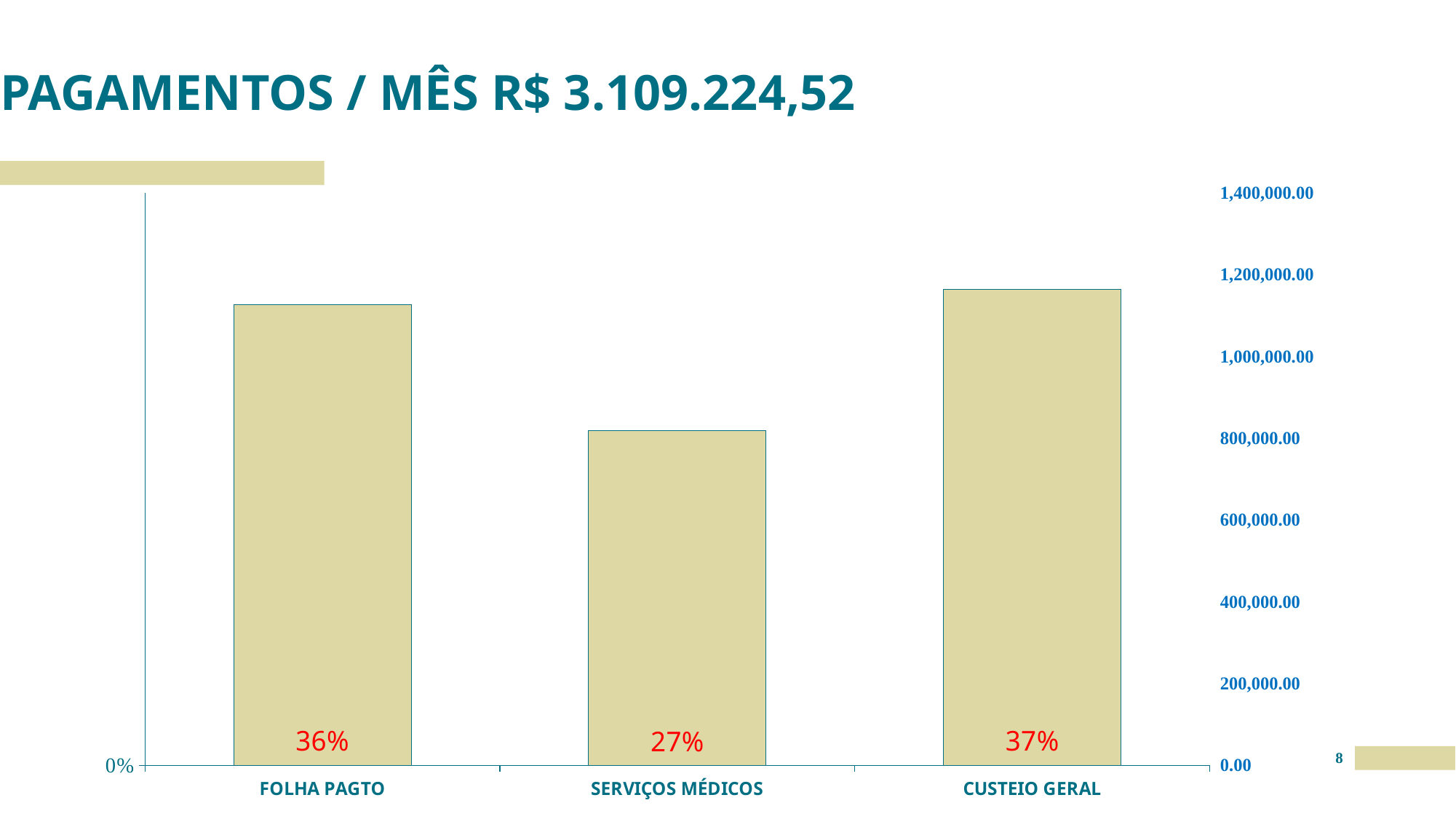
Which category has the highest value? CUSTEIO GERAL What percentage label is shown on the CUSTEIO GERAL bar? 37% What percentage label is shown on the FOLHA PAGTO bar? 36% What kind of chart is shown on the slide? bar chart Is the value for SERVIÇOS MÉDICOS greater or less than 1,000,000.00? less What is the difference in percentage points between the FOLHA PAGTO and SERVIÇOS MÉDICOS labels? 9% How many categories are shown on the x axis? 3 Is the value for FOLHA PAGTO greater or less than 1,000,000.00? greater What percentage label is shown on the SERVIÇOS MÉDICOS bar? 27% Which category has the lowest value? SERVIÇOS MÉDICOS Which is larger, the value for FOLHA PAGTO or the value for SERVIÇOS MÉDICOS? FOLHA PAGTO What is the title of the slide? PAGAMENTOS / MÊS R$ 3.109.224,52